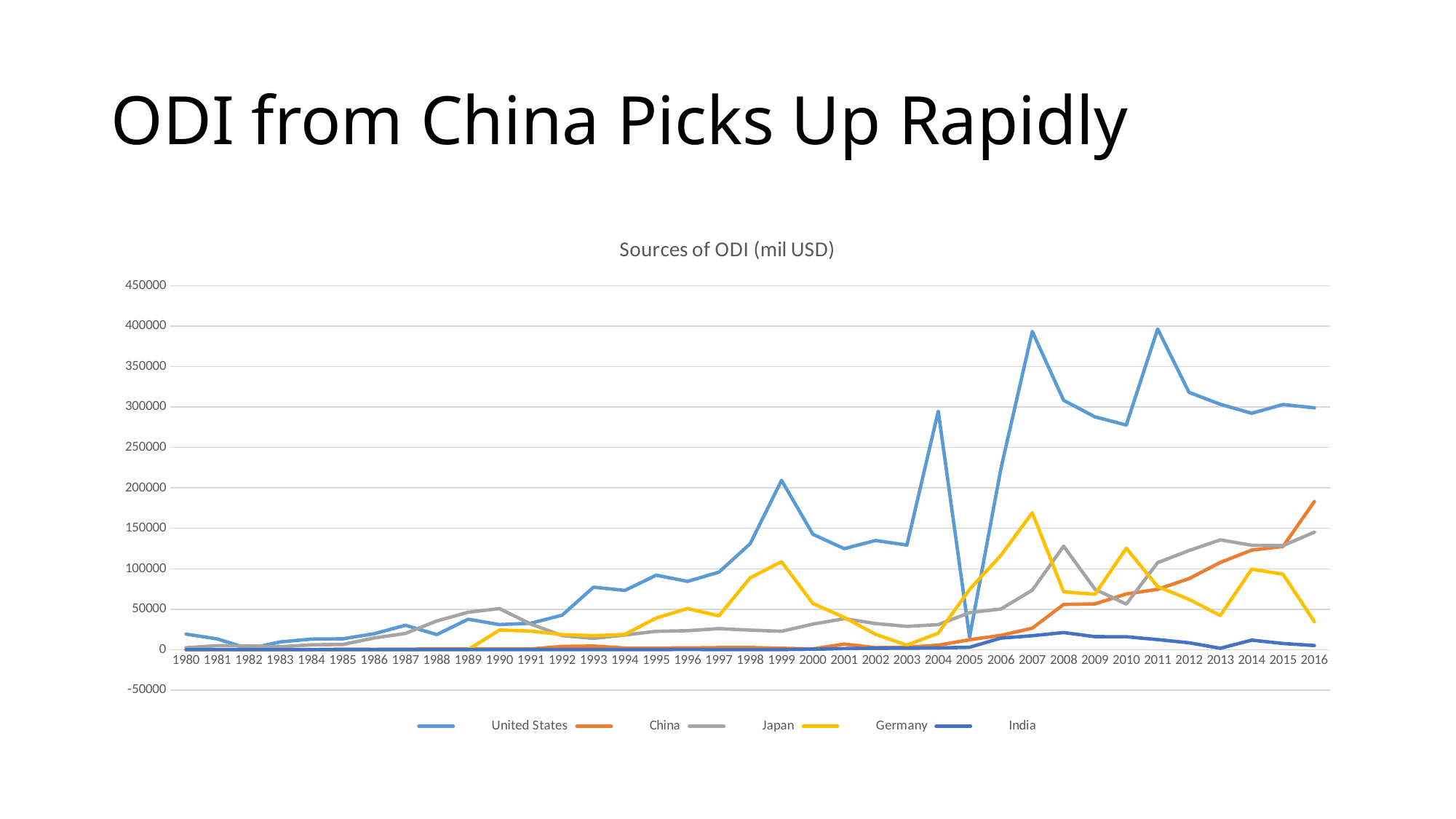
How many series does the legend list? 5 Which series has the highest value in 2016? United States Which series has the lowest value in 2016? India In 2016, which is larger, the value for China or the value for Japan? China Is the value for United States in 2007 greater or less than 350000? greater Is the value for Germany in 2016 greater or less than 50000? less What kind of chart is shown on the slide? line chart In 2007, which is larger, the value for Germany or the value for Japan? Germany How many years are plotted along the x axis? 37 What is the title of the chart? Sources of ODI (mil USD) Is the value for United States in 2005 greater or less than 50000? less